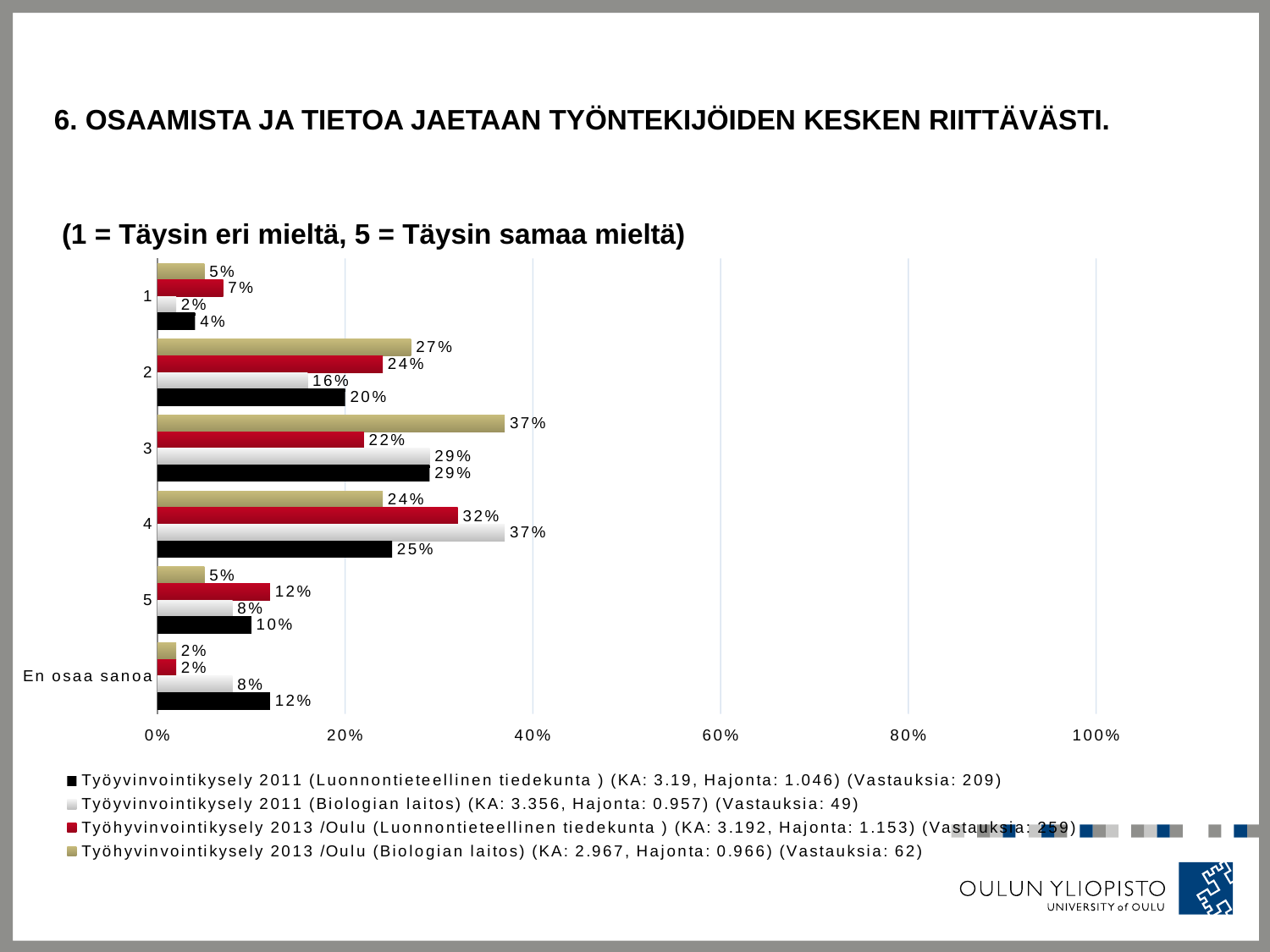
What is the value for category 4 in the Työyvinvointikysely 2011 (Biologian laitos) series? 37% What is the number of responses (Vastauksia) given in the legend for Työhyvinvointikysely 2013 /Oulu (Biologian laitos)? 62 How many series does the legend list? 4 For category 5, which is larger: the Työhyvinvointikysely 2013 /Oulu (Luonnontieteellinen tiedekunta) value or the Työyvinvointikysely 2011 (Luonnontieteellinen tiedekunta) value? Työhyvinvointikysely 2013 /Oulu (Luonnontieteellinen tiedekunta) What is the value for category 2 in the Työhyvinvointikysely 2013 /Oulu (Luonnontieteellinen tiedekunta) series? 24% Which category has the highest value in the Työhyvinvointikysely 2013 /Oulu (Luonnontieteellinen tiedekunta) series? 4 What is the value for 'En osaa sanoa' in the Työyvinvointikysely 2011 (Luonnontieteellinen tiedekunta) series? 12% Which category has the lowest value in the Työyvinvointikysely 2011 (Biologian laitos) series? 1 What kind of chart is shown on the slide? bar chart What is the value for category 3 in the Työhyvinvointikysely 2013 /Oulu (Biologian laitos) series? 37% How many categories are shown on the vertical axis? 6 What is the difference between the Työhyvinvointikysely 2013 /Oulu (Biologian laitos) value and the Työhyvinvointikysely 2013 /Oulu (Luonnontieteellinen tiedekunta) value for category 3? 15%